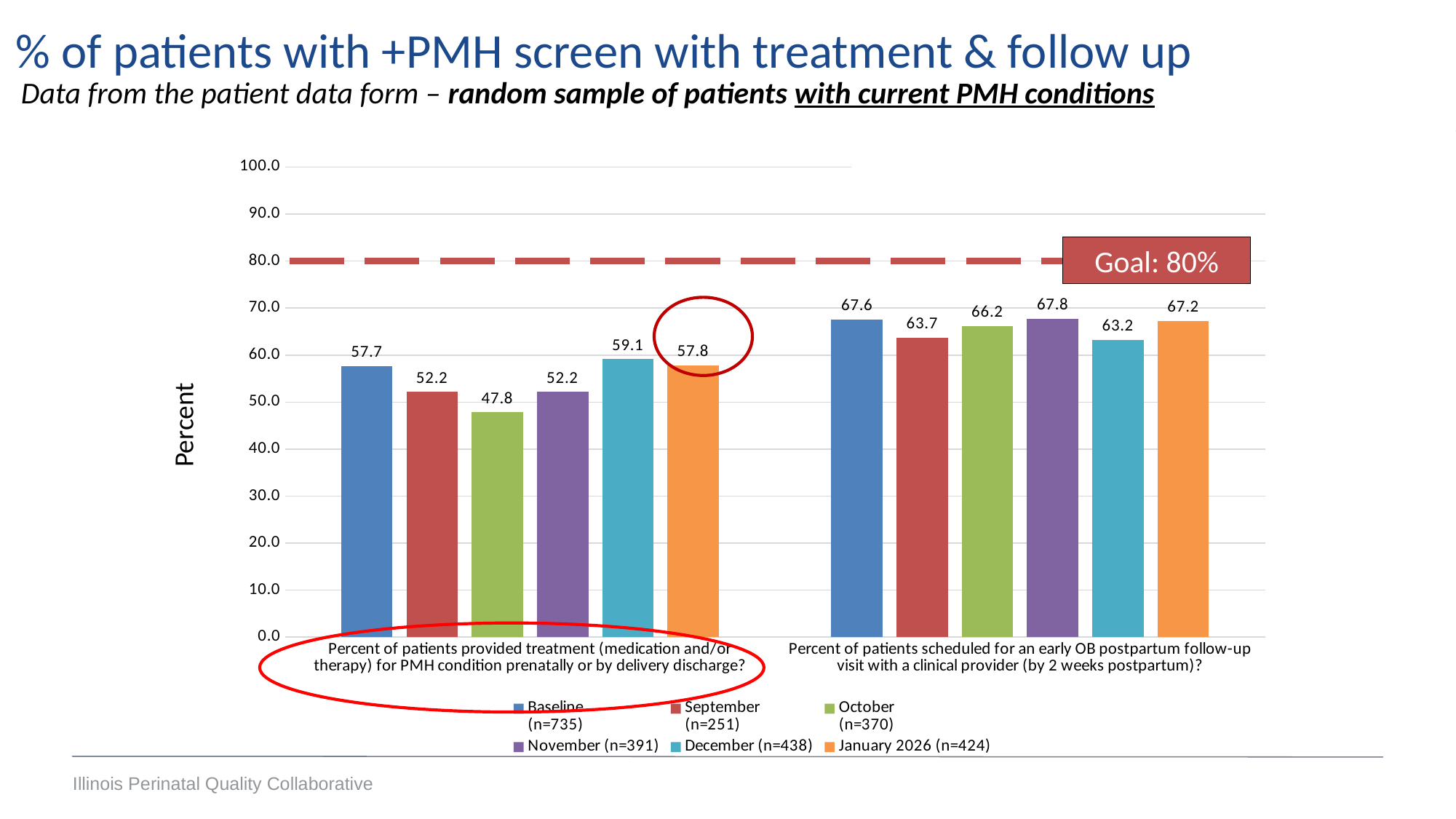
What is the Baseline (n=735) value for the early OB postpartum follow-up visit category? 67.6 Which series has the highest value for the category about patients provided treatment for PMH condition prenatally or by delivery discharge? December (n=438) Which series has the lowest value for the category about patients provided treatment for PMH condition prenatally or by delivery discharge? October (n=370) What goal percentage is marked by the dashed line on the chart? 80% Which series has the lowest value for the early OB postpartum follow-up visit category? December (n=438) What type of chart is shown on the slide? Bar chart How many series does the legend list? 6 Is the Baseline (n=735) value for the early OB postpartum follow-up visit category greater or less than 80? less What is the value for January 2026 (n=424) for the category 'Percent of patients scheduled for an early OB postpartum follow-up visit with a clinical provider (by 2 weeks postpartum)?'? 67.2 What is the difference between the December (n=438) and October (n=370) values for the category about patients provided treatment for PMH condition? 11.3 What is the value for December (n=438) for the category 'Percent of patients provided treatment (medication and/or therapy) for PMH condition prenatally or by delivery discharge?'? 59.1 For the early OB postpartum follow-up visit category, which is larger: the November (n=391) value or the September (n=251) value? November (n=391)